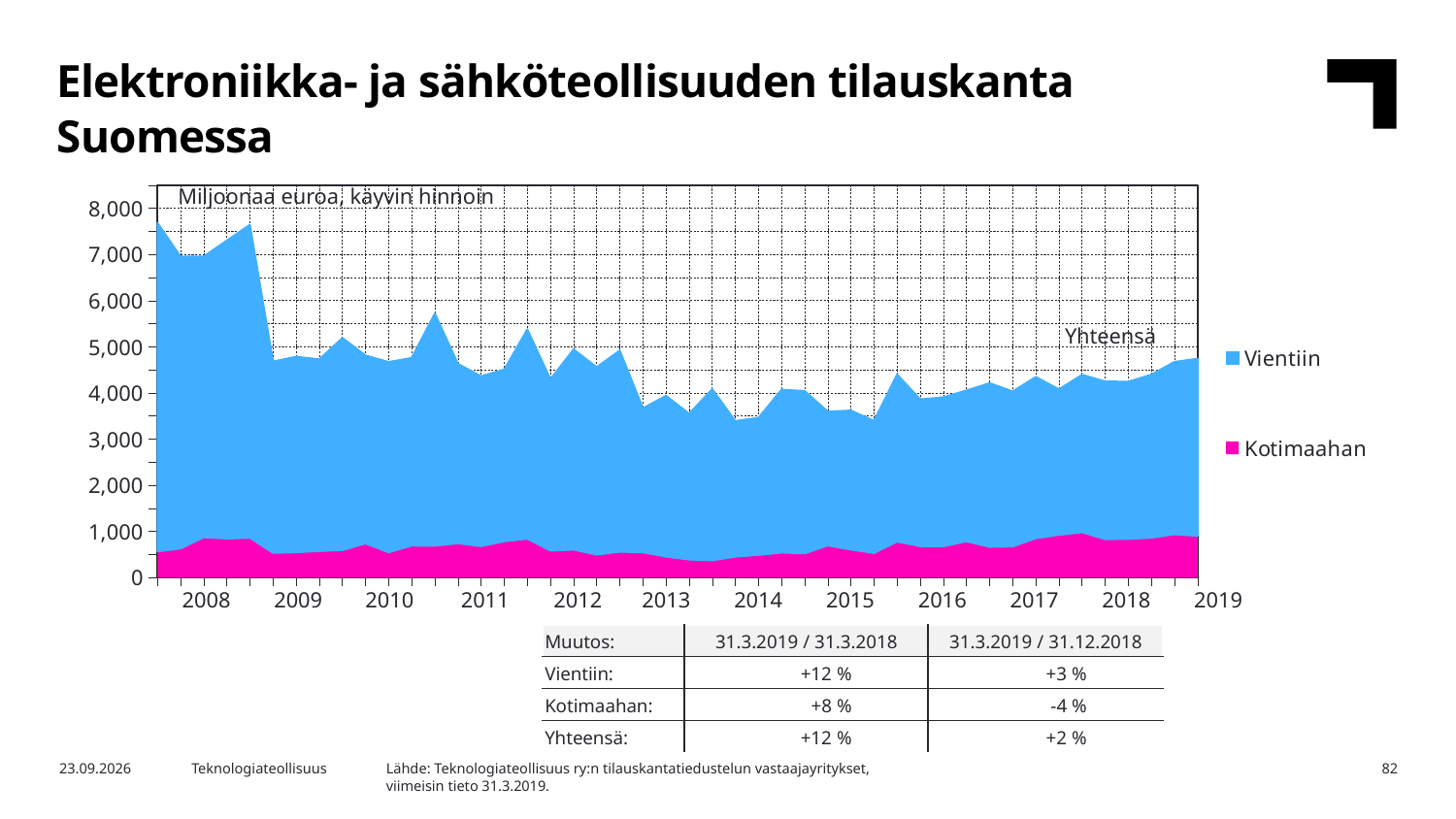
Overall, does the total order backlog rise or fall from 2008 to 2019? Fall What kind of chart is shown on the slide? Stacked area chart Is the Kotimaahan value at the start of 2014 greater or less than 1,000? less Is the total order backlog (Yhteensä) at the start of 2019 greater or less than 5,000? less Which is larger at the start of 2019: the Vientiin area or the Kotimaahan area? Vientiin Which series is shown in magenta (pink) in the chart? Kotimaahan How many series does the chart legend list? 2 Which two series are listed in the chart legend? Vientiin and Kotimaahan Is the total order backlog (Yhteensä) at the start of 2016 greater or less than 3,000? greater What unit label is printed at the top of the chart? Miljoonaa euroa, käyvin hinnoin Is the total order backlog higher at the start of 2008 or at the start of 2019? 2008